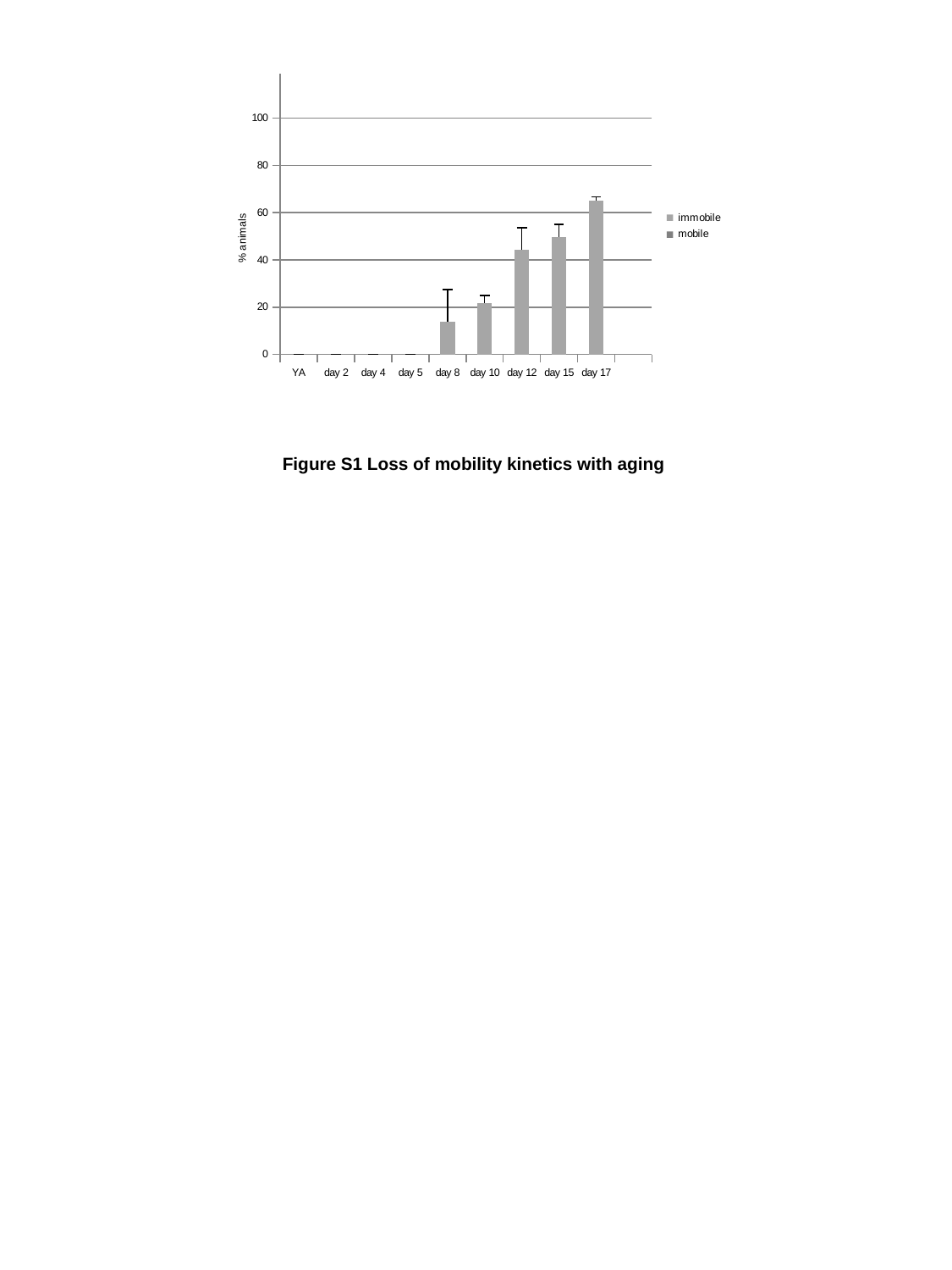
Is the value for day 8 greater or less than 20? less What is the label on the y axis? % animals Do the bar values rise or fall from day 8 to day 17? rise How many categories are shown along the x axis? 9 Is the value for day 10 greater or less than 40? less Is the value for day 12 greater or less than 40? greater Which category has the highest bar? day 17 How many series does the legend list? 2 What kind of chart is shown on the slide? bar chart Which is larger, the value for day 17 or the value for day 8? day 17